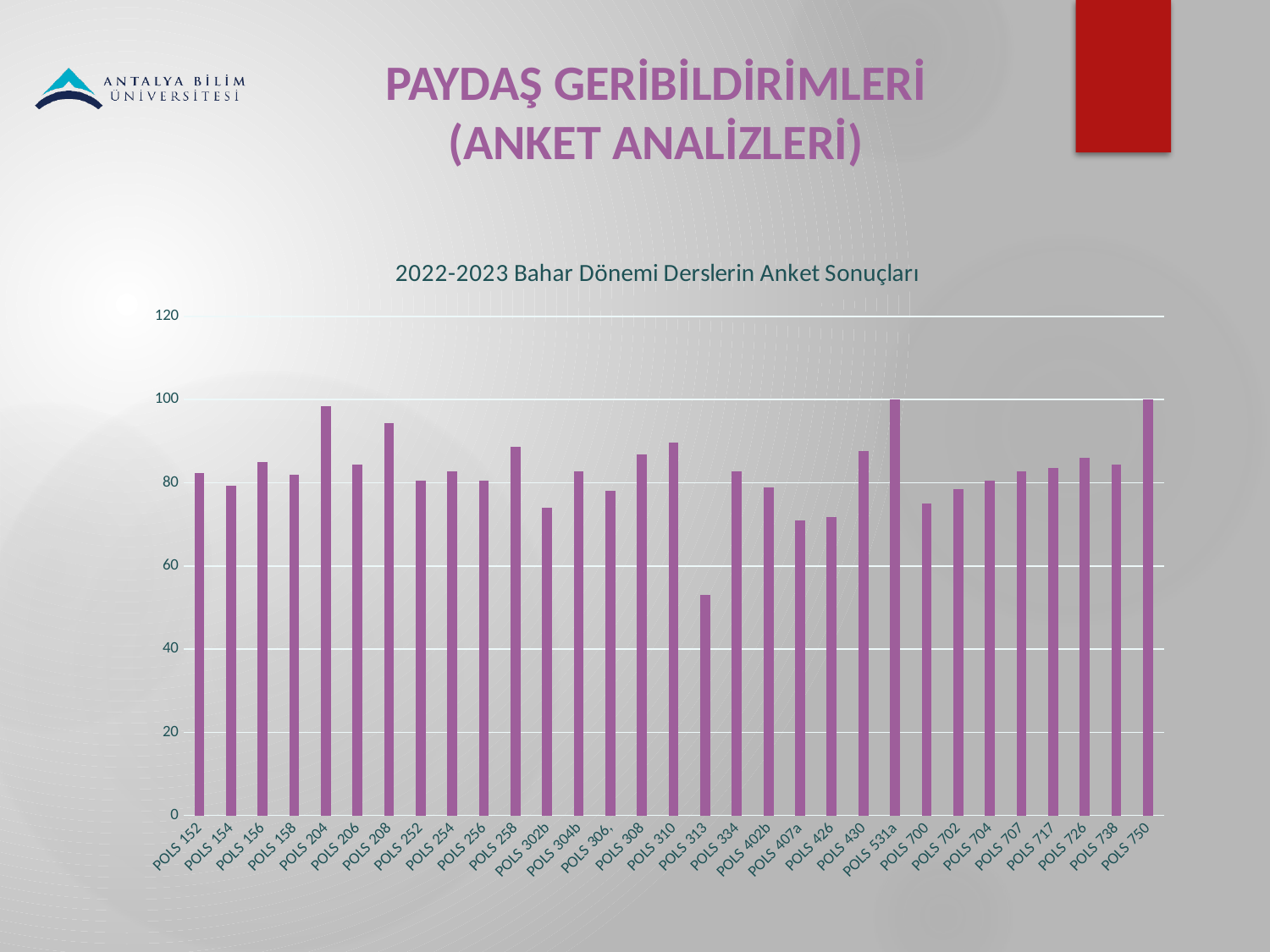
What is the title of the chart? 2022-2023 Bahar Dönemi Derslerin Anket Sonuçları Is the value for POLS 407a greater or less than 80? less Is the value for POLS 313 greater or less than 60? less What kind of chart is shown on the slide? bar chart Is the value for POLS 204 greater or less than 80? greater How many courses (categories) are plotted on the x axis? 31 Which is larger, the value for POLS 313 or the value for POLS 334? POLS 334 Which is larger, the value for POLS 204 or the value for POLS 154? POLS 204 What is the highest value shown on the y axis? 120 What is the value for POLS 531a? 100 Which course has the lowest survey result? POLS 313